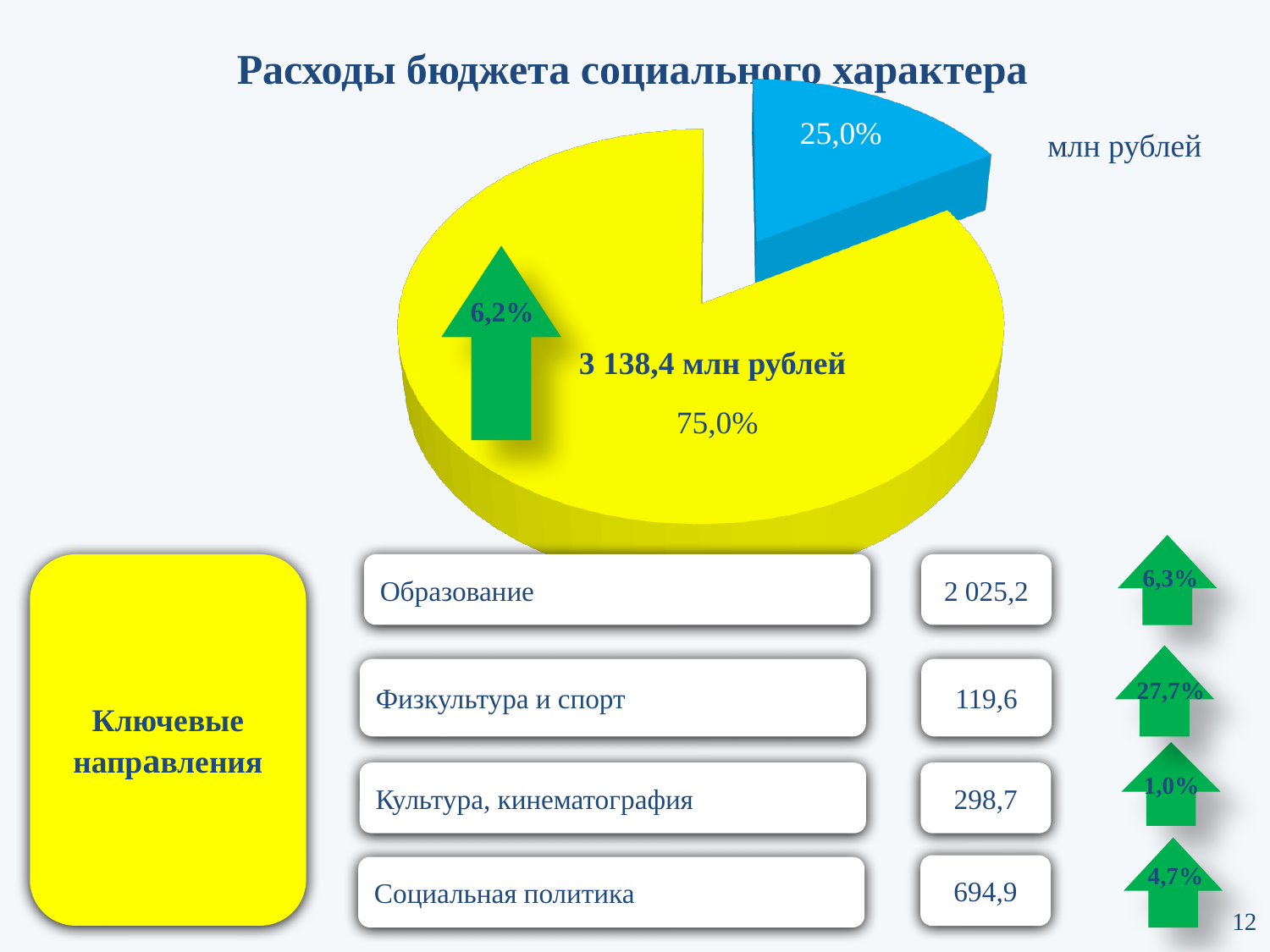
What value in млн рублей is printed on the yellow slice of the pie chart? 3 138,4 млн рублей What is the title of the chart on the slide? Расходы бюджета социального характера By how many percentage points does the yellow slice's share exceed the blue slice's share? 50,0 What share of the pie does the blue slice represent? 25,0% Which slice of the pie chart is the smallest? the blue slice (25,0%) Which slice of the pie chart is the largest? the yellow slice (75,0%) What growth percentage is shown on the green arrow inside the yellow slice of the pie chart? 6,2% What share of the pie does the yellow slice represent? 75,0% Which slice of the pie chart is larger, the yellow one or the blue one? the yellow one How many slices does the pie chart have? 2 What kind of chart is shown on the slide? pie chart